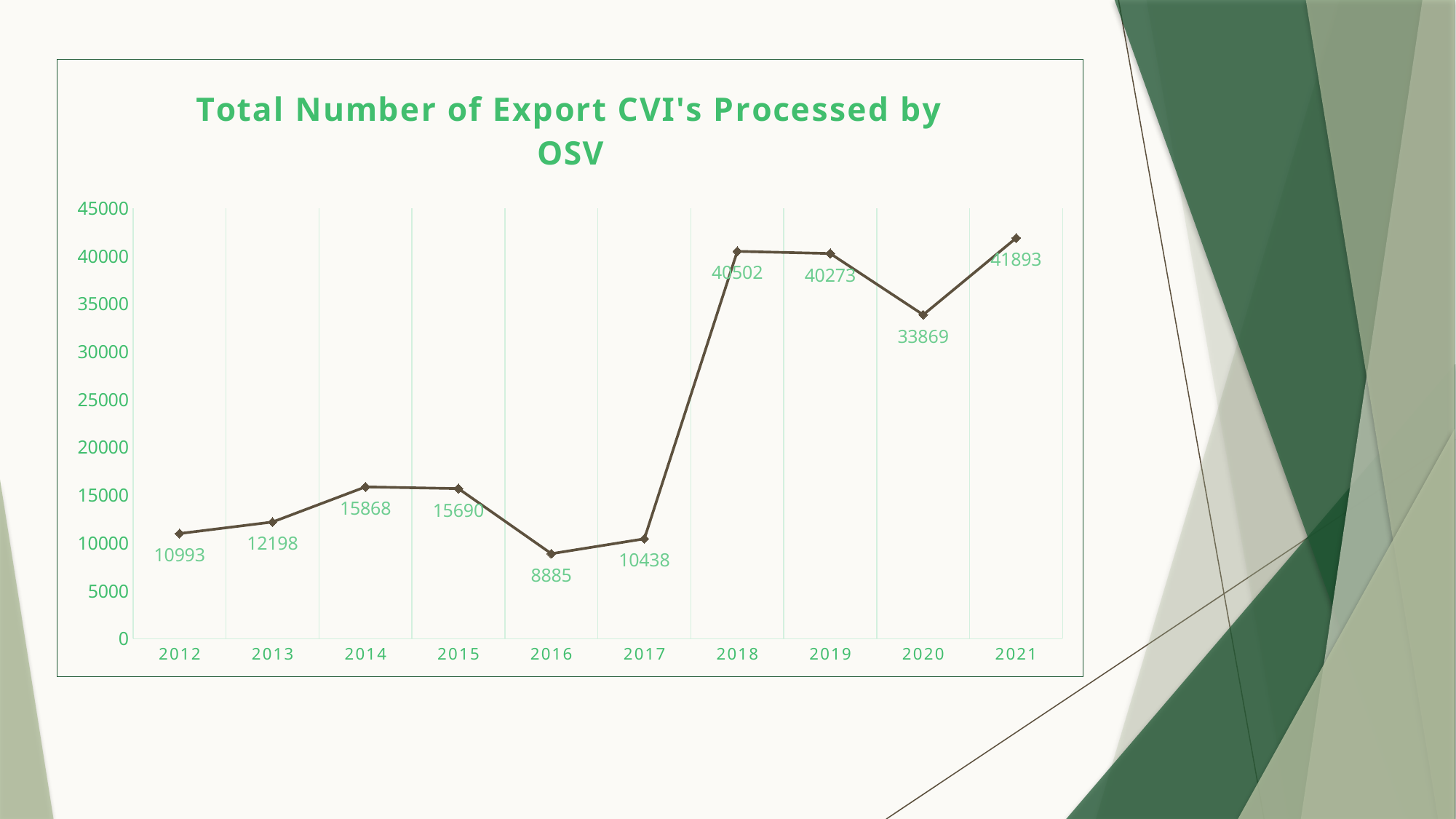
What is the value for 2018? 40502 What is the value for 2020? 33869 Which is larger, the value for 2014 or the value for 2015? 2014 Which year has the lowest value? 2016 What is the difference between the values for 2021 and 2020? 8024 What is the title of the chart? Total Number of Export CVI's Processed by OSV What kind of chart is shown on the slide? line chart Is the value for 2019 greater or less than 35000? greater What is the difference between the values for 2018 and 2017? 30064 Which year has the highest value? 2021 How many years are plotted on the chart? 10 What is the value for 2016? 8885